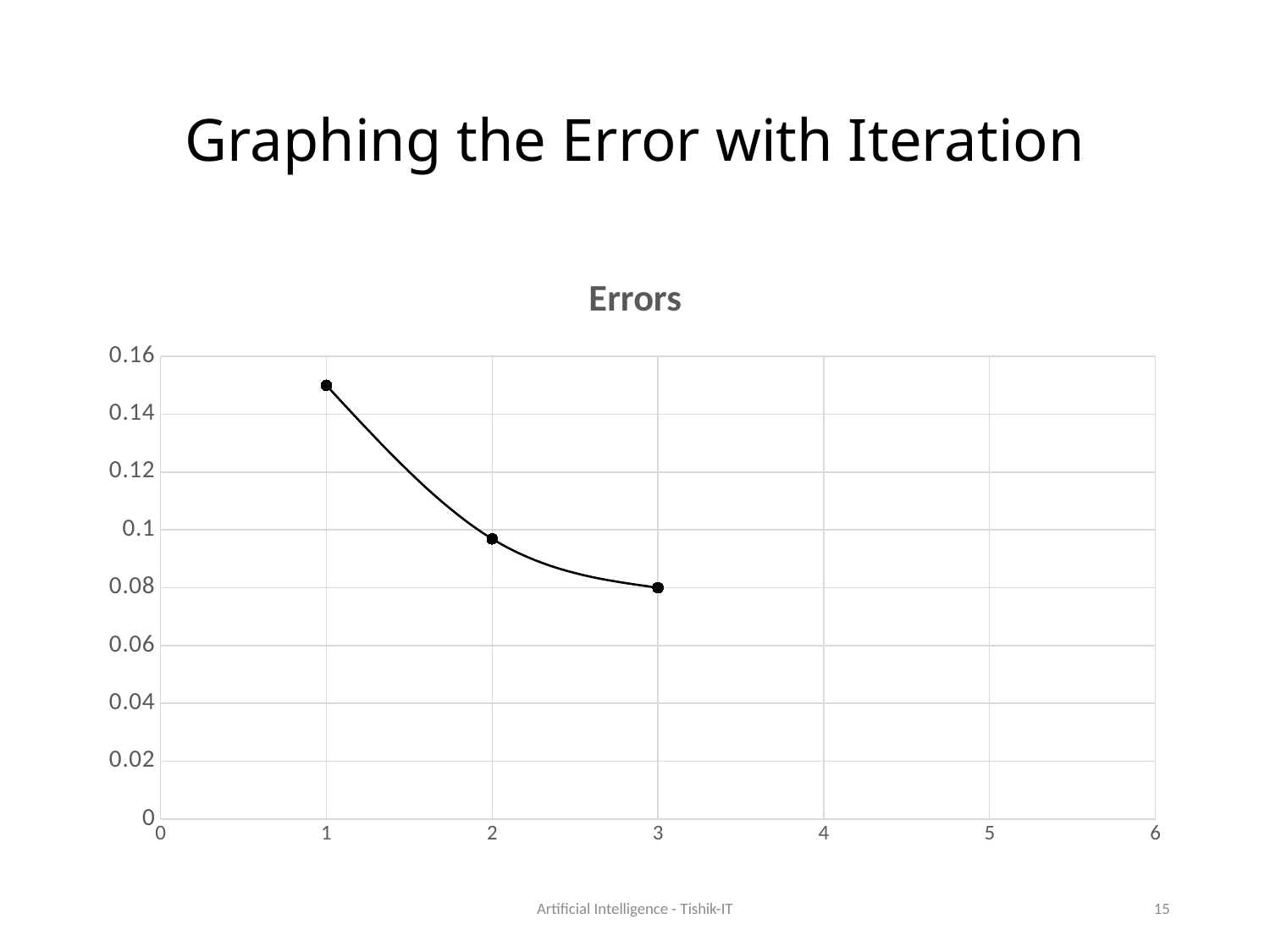
Is the error at iteration 1 greater or less than 0.14? greater Is the error at iteration 1 greater or less than 0.16? less What kind of chart is shown on the slide? line chart Which has the larger error, iteration 2 or iteration 3? iteration 2 How many data points are plotted on the chart? 3 Which has the larger error, iteration 1 or iteration 2? iteration 1 At which iteration is the error lowest? 3 Do the error values rise or fall as the iteration number increases? fall At which iteration is the error highest? 1 Is the error at iteration 2 greater or less than 0.08? greater What is the title of the chart? Errors